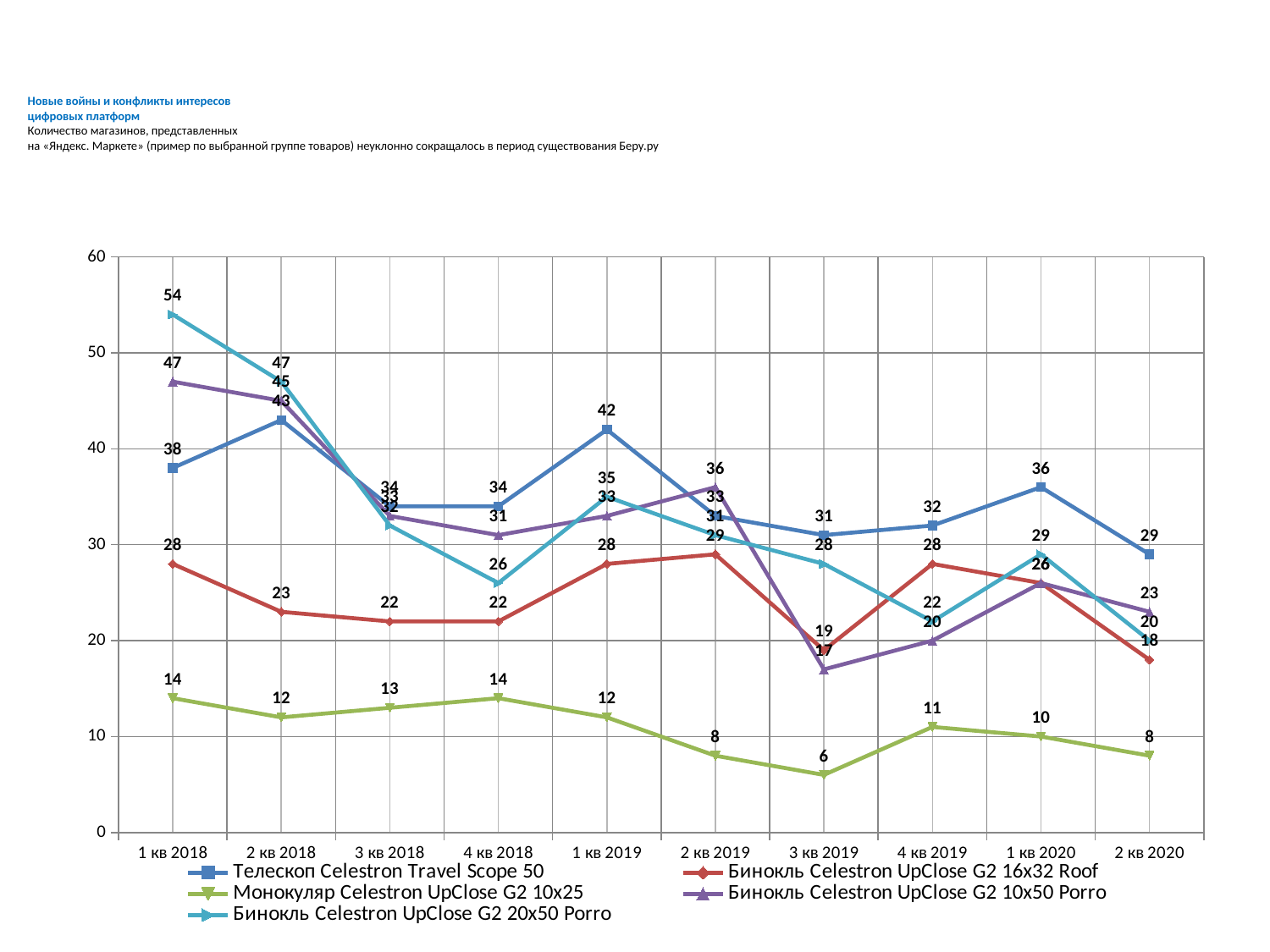
How many quarters are shown on the x axis? 10 What is the value for Телескоп Celestron Travel Scope 50 in 1 кв 2019? 42 What kind of chart is shown on the slide? line chart What is the value for Бинокль Celestron UpClose G2 16x32 Roof in 2 кв 2020? 18 What is the value for Монокуляр Celestron UpClose G2 10x25 in 3 кв 2019? 6 What is the difference between the values for Бинокль Celestron UpClose G2 20x50 Porro in 1 кв 2018 and 2 кв 2020? 34 What is the value for Бинокль Celestron UpClose G2 20x50 Porro in 1 кв 2018? 54 Does the value for Монокуляр Celestron UpClose G2 10x25 rise or fall from 1 кв 2018 to 2 кв 2020? fall Which is larger in 3 кв 2019: the value for Бинокль Celestron UpClose G2 16x32 Roof or for Бинокль Celestron UpClose G2 10x50 Porro? Бинокль Celestron UpClose G2 16x32 Roof Which series has the highest value in 1 кв 2018? Бинокль Celestron UpClose G2 20x50 Porro In which quarter does Монокуляр Celestron UpClose G2 10x25 reach its lowest value? 3 кв 2019 How many series does the legend list? 5